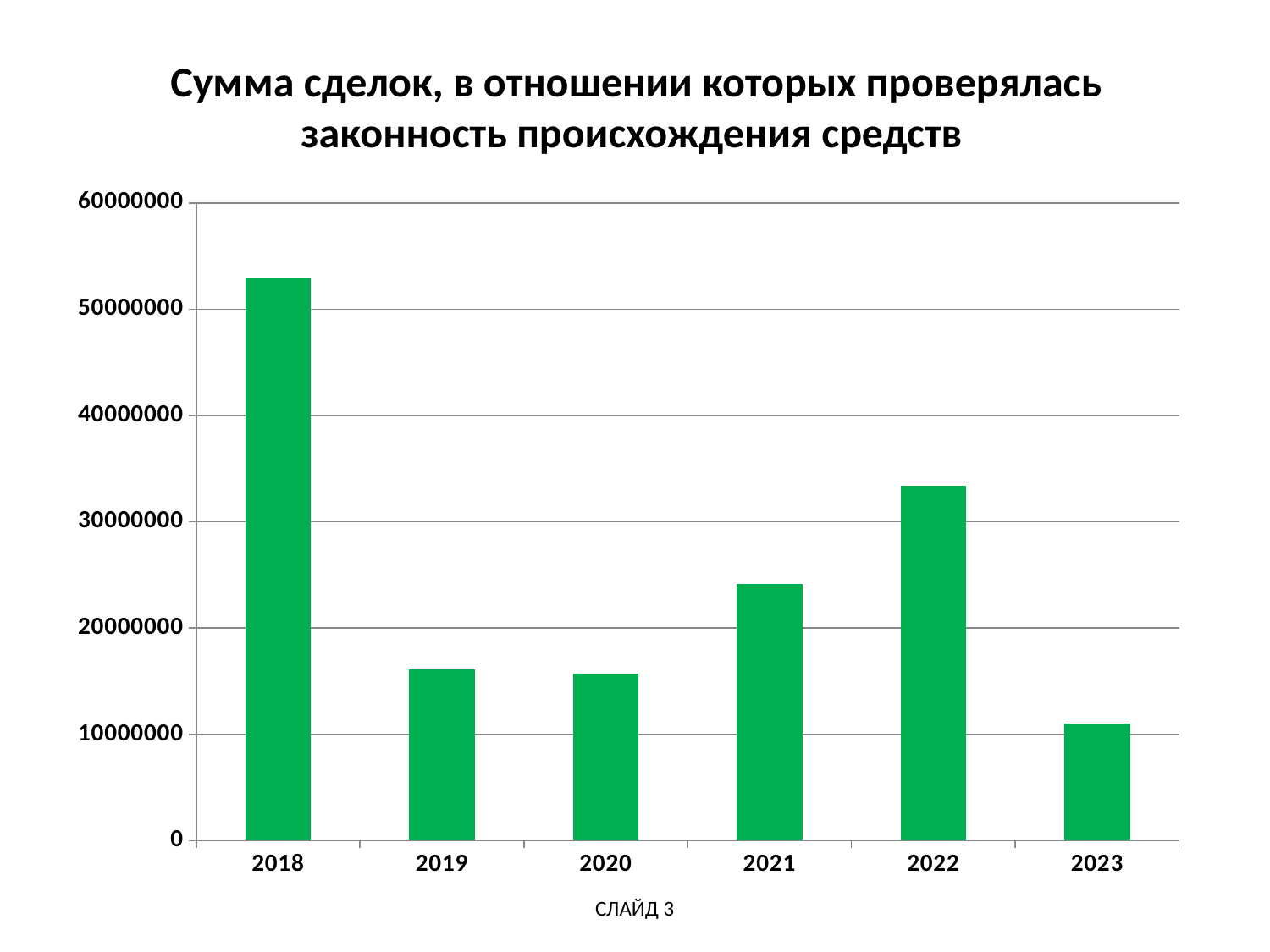
What colour are the bars in the chart? green Which year has the lowest value in the chart? 2023 Is the value for 2019 greater or less than 20000000? less Is the value for 2018 greater or less than 50000000? greater How many years are shown on the x axis of the chart? 6 Which year has the highest value in the chart? 2018 Is the value for 2022 greater or less than 30000000? greater Which year has the larger value, 2021 or 2019? 2021 What kind of chart is shown on the slide? bar chart Do the values rise or fall from 2020 to 2022? rise Which year has the larger value, 2018 or 2022? 2018